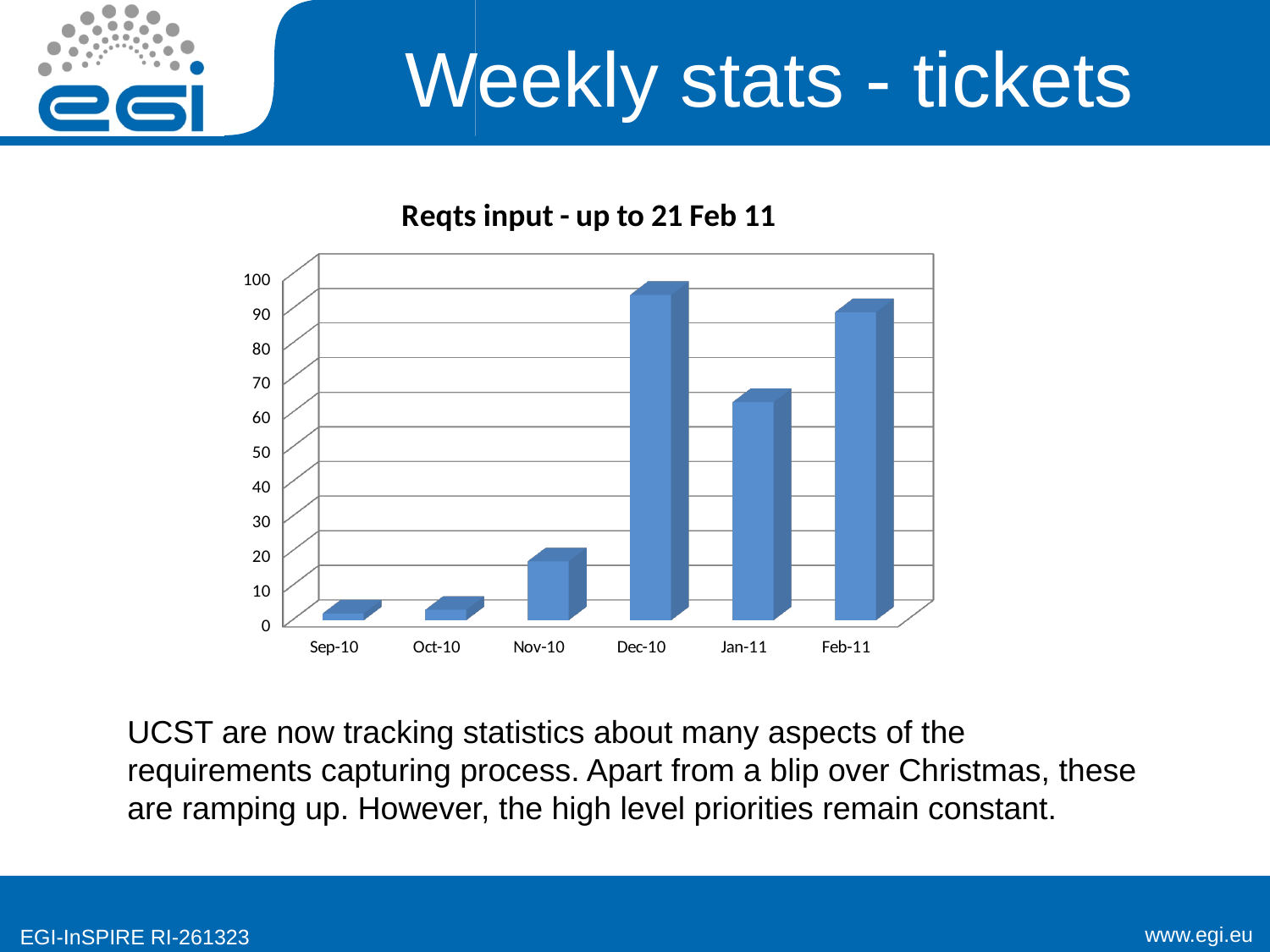
How many months are shown on the x axis of the chart? 6 Which is larger, the value for Nov-10 or the value for Feb-11? Feb-11 Which month has the highest value in the chart? Dec-10 Is the value for Jan-11 greater or less than 50? greater Do the values rise or fall from Sep-10 to Dec-10? rise Is the value for Feb-11 greater or less than 70? greater Is the value for Dec-10 greater or less than 80? greater What is the title of the chart? Reqts input - up to 21 Feb 11 What kind of chart is shown on the slide? bar chart Which is larger, the value for Dec-10 or the value for Jan-11? Dec-10